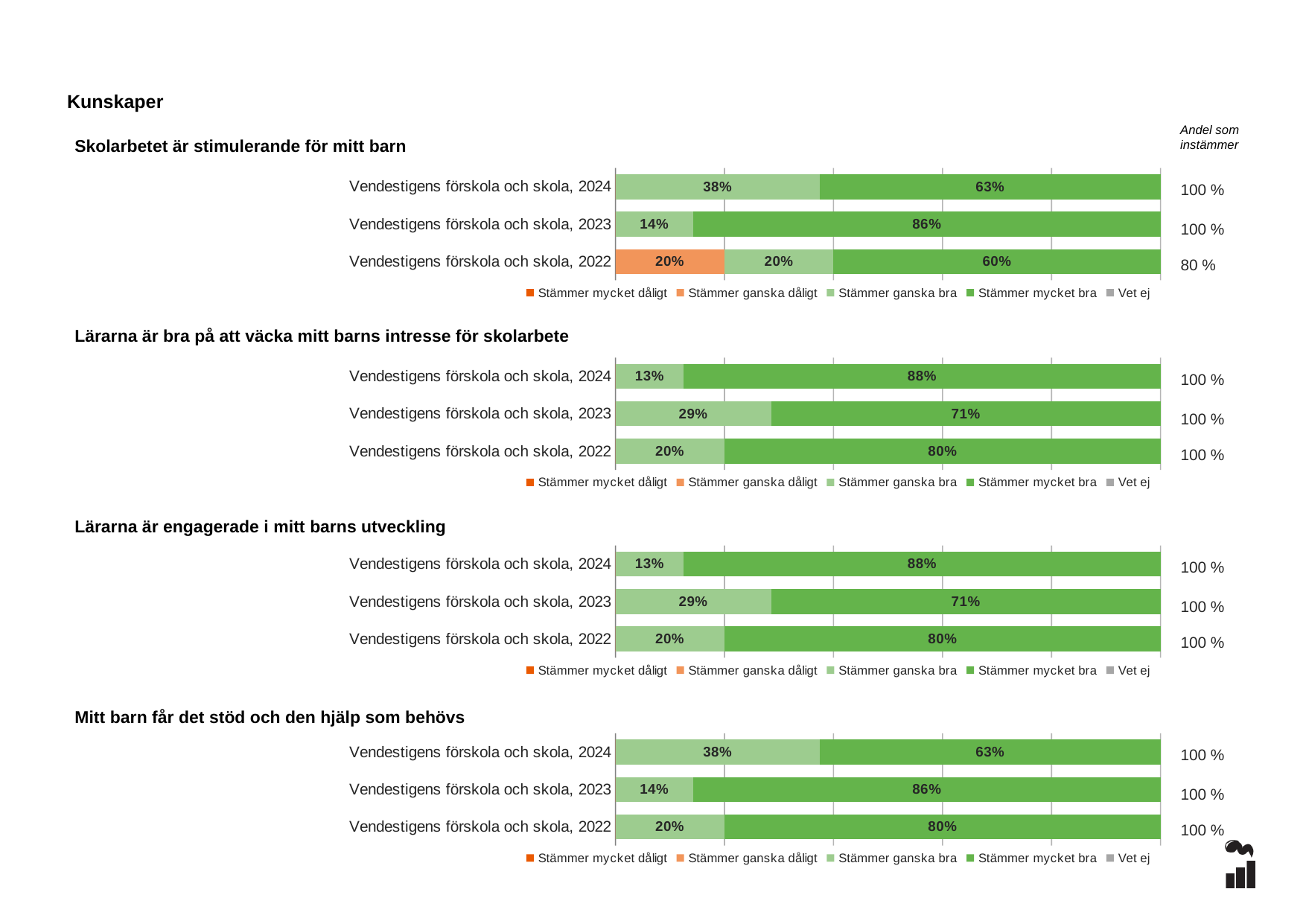
In the chart 'Skolarbetet är stimulerande för mitt barn', what is the difference between the 'Stämmer mycket bra' values for 2023 and 2024? 23% How many series does the legend list for the chart 'Skolarbetet är stimulerande för mitt barn'? 5 In the chart 'Lärarna är bra på att väcka mitt barns intresse för skolarbete', what is the 'Stämmer mycket bra' value for Vendestigens förskola och skola, 2024? 88% In the chart 'Mitt barn får det stöd och den hjälp som behövs', what is the difference between the 'Stämmer mycket bra' values for 2023 and 2022? 6% In the chart 'Lärarna är bra på att väcka mitt barns intresse för skolarbete', which year has the lowest 'Stämmer mycket bra' value? 2023 In the chart 'Lärarna är engagerade i mitt barns utveckling', what is the 'Stämmer ganska bra' value for Vendestigens förskola och skola, 2023? 29% In the chart 'Mitt barn får det stöd och den hjälp som behövs', what is the 'Stämmer ganska bra' value for Vendestigens förskola och skola, 2024? 38% In the chart 'Lärarna är engagerade i mitt barns utveckling', is the 'Stämmer mycket bra' value for 2022 larger or smaller than the value for 2023? larger In the chart 'Skolarbetet är stimulerande för mitt barn', what is the 'Stämmer mycket bra' value for Vendestigens förskola och skola, 2023? 86% How many bars are shown in the chart 'Mitt barn får det stöd och den hjälp som behövs'? 3 In the chart 'Skolarbetet är stimulerande för mitt barn', which year has the highest 'Stämmer mycket bra' value? 2023 In the chart 'Skolarbetet är stimulerande för mitt barn', what is the 'Stämmer ganska dåligt' value for Vendestigens förskola och skola, 2022? 20%